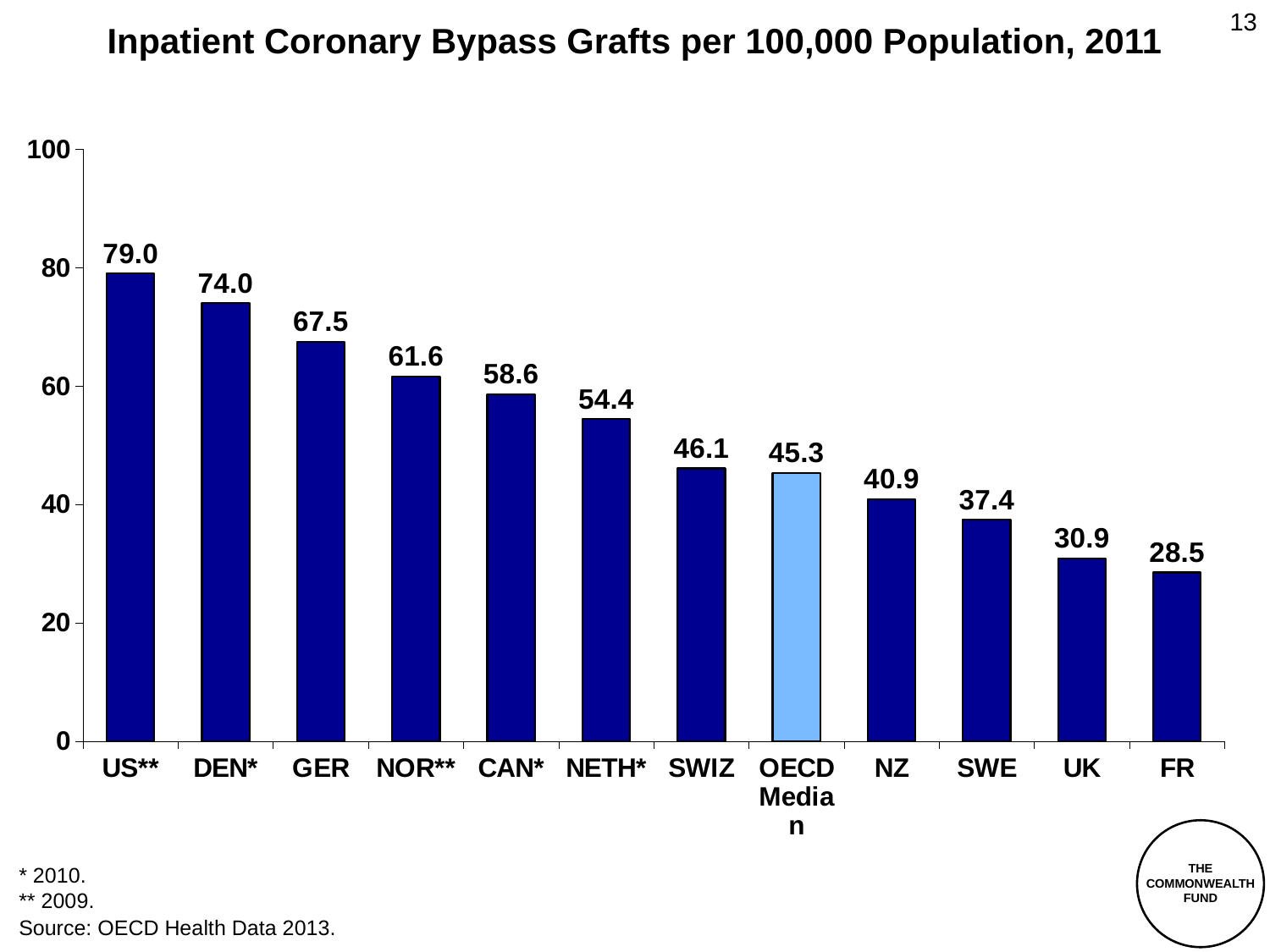
What is the value for GER? 67.5 Is the value for SWE greater or less than 40? less Which category has the lowest value? FR What kind of chart is this? bar chart What is the difference between the values for SWIZ and the OECD Median? 0.8 How many categories are shown on the x axis? 12 What is the difference between the values for US** and DEN*? 5.0 Which category has the highest value? US** Which is larger, the value for CAN* or the value for NETH*? CAN* Do the values rise or fall from left to right along the x axis? fall What is the value for the OECD Median? 45.3 What is the value for UK? 30.9